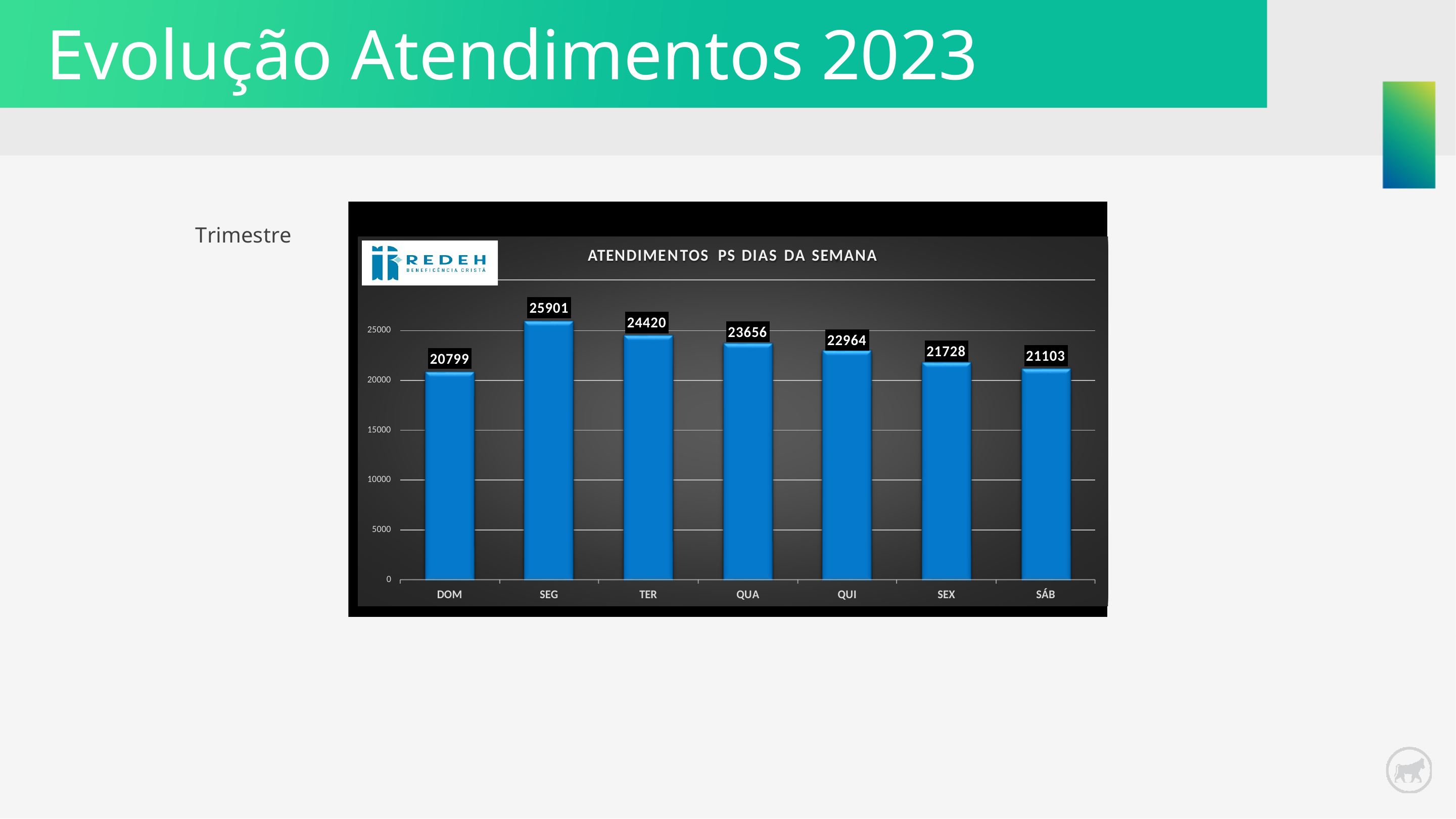
What is the value for SEG? 25901 What is the difference between the values for TER and QUA? 764 Which is larger, the value for SEX or the value for SÁB? SEX What is the value for DOM? 20799 Is the value for QUA greater or less than 25000? less Which day has the highest value? SEG What is the value for QUI? 22964 What is the difference between the values for SEG and DOM? 5102 How many days are shown on the x axis? 7 What is the title of the chart? ATENDIMENTOS PS DIAS DA SEMANA What kind of chart is shown? bar chart Which day has the lowest value? DOM